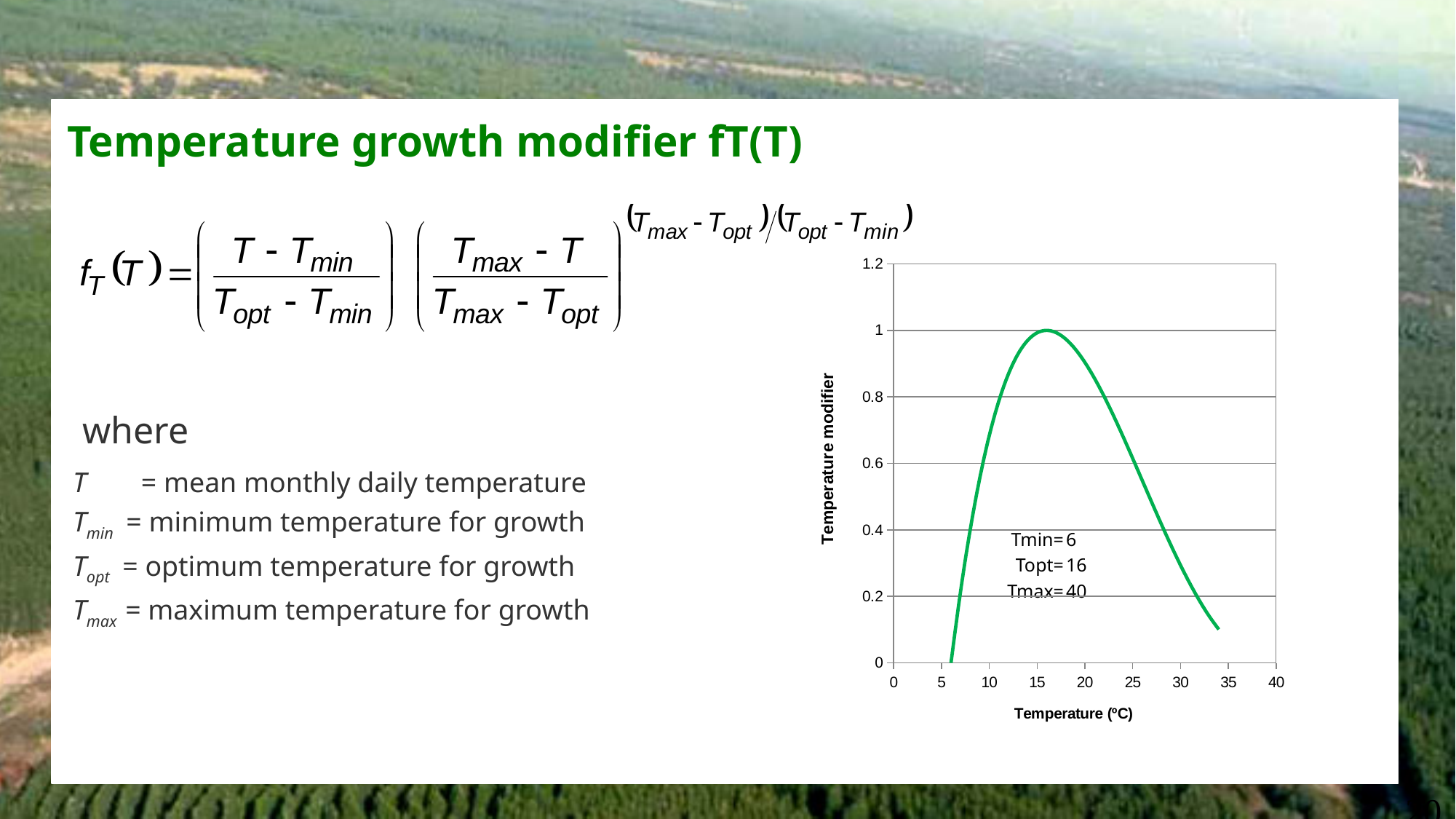
Does the temperature modifier rise or fall as temperature increases from 20 ºC to 35 ºC? fall What value of Tmin is annotated on the chart? 6 What kind of chart is shown on the slide? line chart What value of Tmax is annotated on the chart? 40 Which is larger, the temperature modifier at 15 ºC or at 30 ºC? 15 ºC What value of Topt is annotated on the chart? 16 What is the label of the y axis of the chart? Temperature modifier Is the temperature modifier at 30 ºC greater or less than 0.6? less What is the label of the x axis of the chart? Temperature (ºC) Is the temperature modifier at 10 ºC greater or less than 0.6? greater What is the maximum value of the temperature modifier reached by the curve? 1 At what temperature does the curve reach its peak value? 16